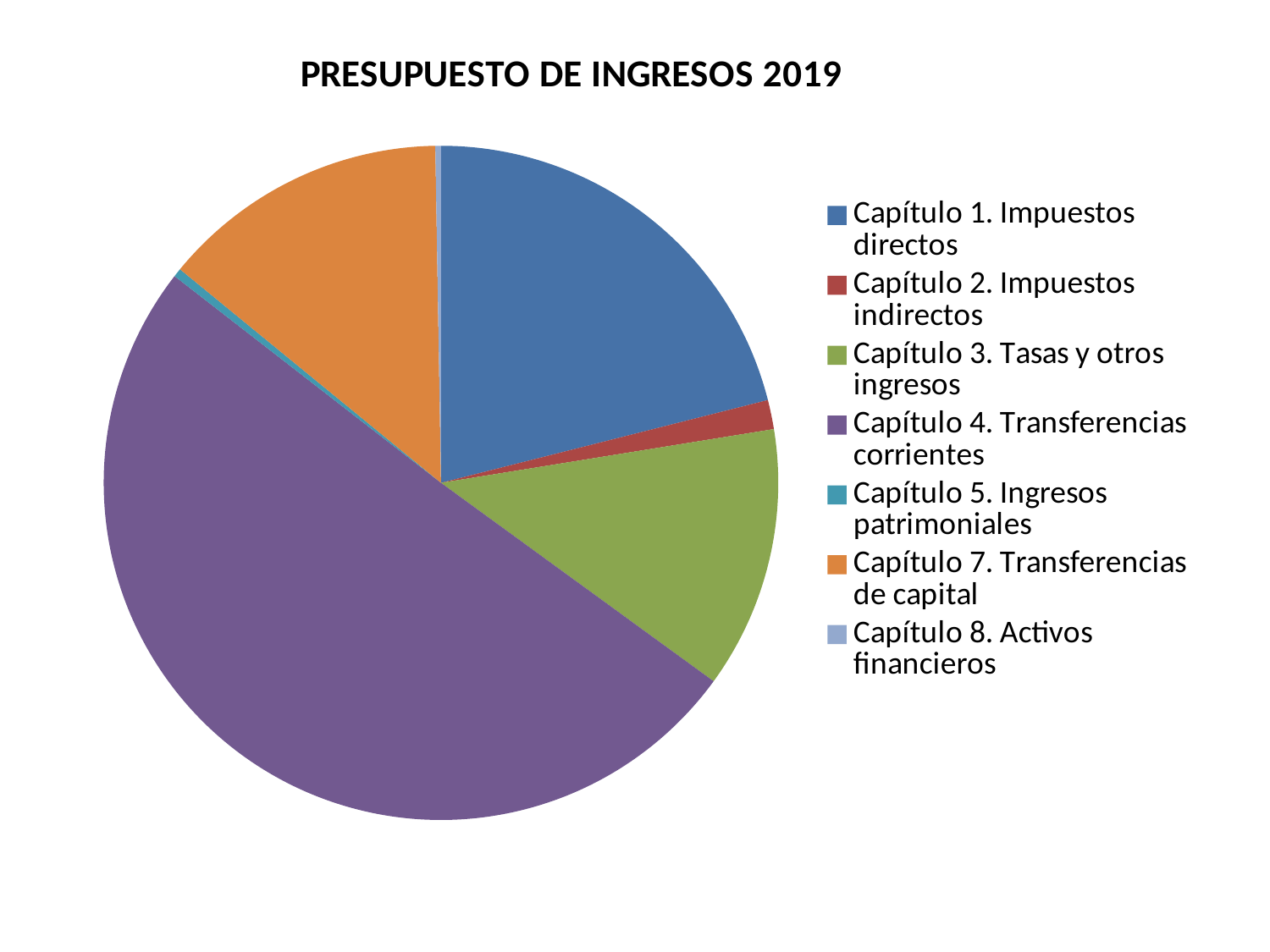
What kind of chart is shown on the slide? pie chart Which slice is larger, Capítulo 1. Impuestos directos or Capítulo 3. Tasas y otros ingresos? Capítulo 1. Impuestos directos Which category has the largest slice of the pie? Capítulo 4. Transferencias corrientes Which slice is larger, Capítulo 7. Transferencias de capital or Capítulo 2. Impuestos indirectos? Capítulo 7. Transferencias de capital What is the title of the chart? PRESUPUESTO DE INGRESOS 2019 Which slice is larger, Capítulo 4. Transferencias corrientes or Capítulo 1. Impuestos directos? Capítulo 4. Transferencias corrientes What colour is the slice for Capítulo 4. Transferencias corrientes? purple How many categories (slices) does the pie chart have? 7